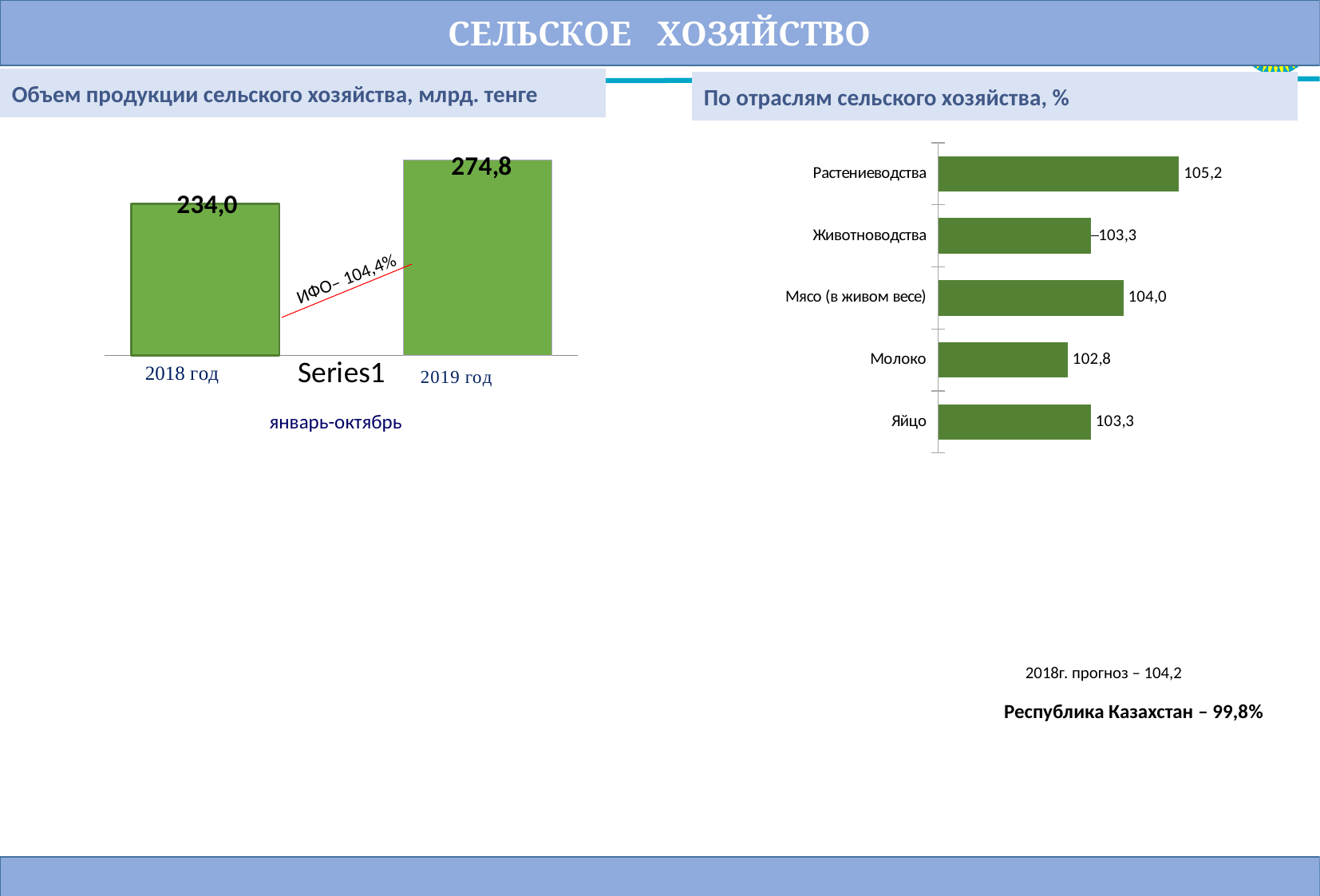
In the chart 'По отраслям сельского хозяйства, %', what is the value for Молоко? 102,8 What kind of chart is 'Объем продукции сельского хозяйства, млрд. тенге'? bar chart In the chart 'По отраслям сельского хозяйства, %', which is larger: Мясо (в живом весе) or Яйцо? Мясо (в живом весе) In the chart 'По отраслям сельского хозяйства, %', which category has the lowest value? Молоко In the chart 'По отраслям сельского хозяйства, %', which category has the highest value? Растениеводства In the chart 'По отраслям сельского хозяйства, %', how many categories are shown? 5 In the chart 'По отраслям сельского хозяйства, %', what is the value for Растениеводства? 105,2 In the chart 'По отраслям сельского хозяйства, %', what is the difference between Растениеводства and Животноводства? 1,9 In the chart 'Объем продукции сельского хозяйства, млрд. тенге', what is the difference between the 2019 год and 2018 год values? 40,8 In the chart 'Объем продукции сельского хозяйства, млрд. тенге', do the values rise or fall from 2018 год to 2019 год? rise In the chart 'Объем продукции сельского хозяйства, млрд. тенге', what is the value for 2019 год? 274,8 In the chart 'Объем продукции сельского хозяйства, млрд. тенге', what is the value for 2018 год? 234,0